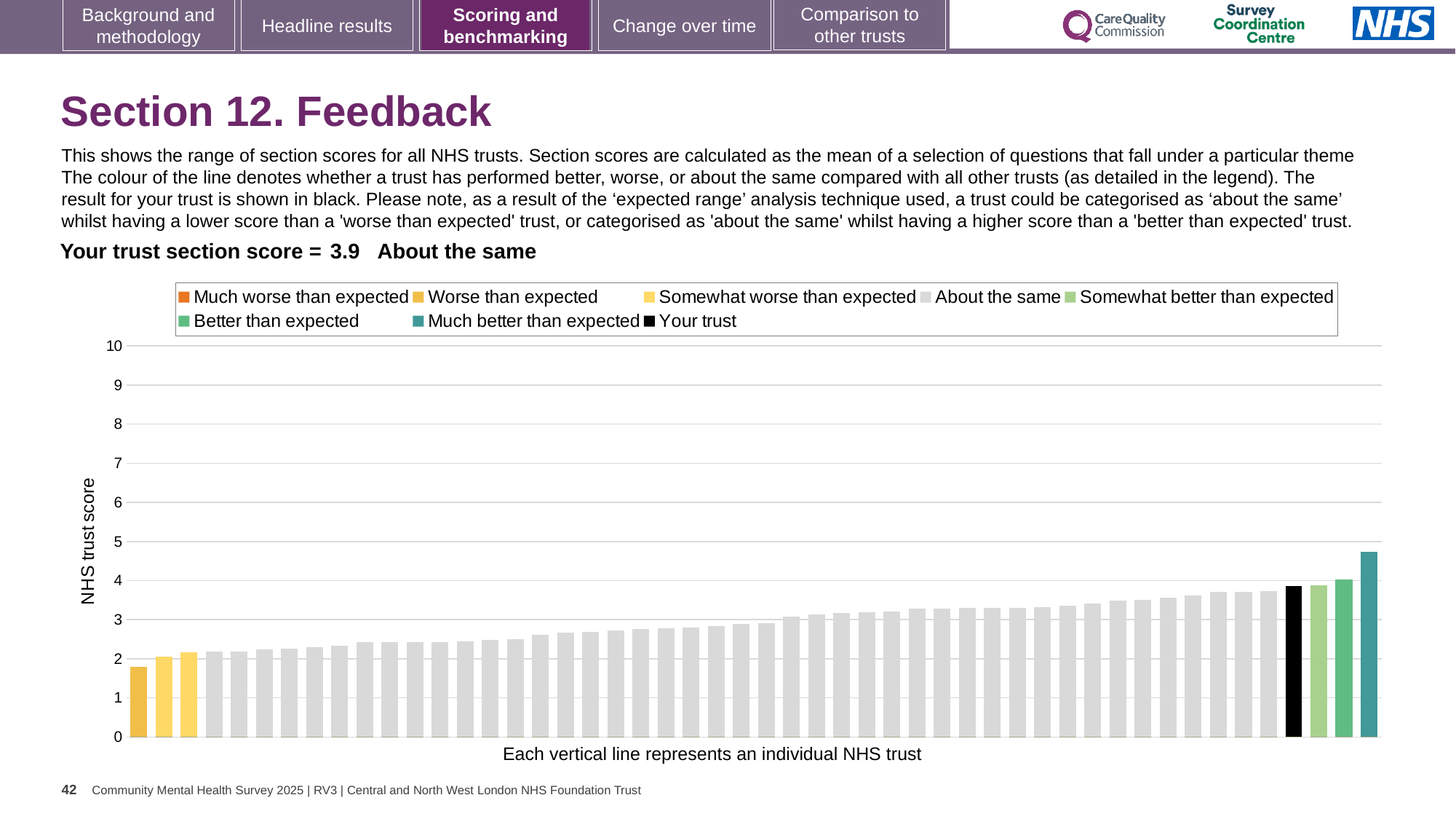
How many entries does the chart legend list? 8 What colour is used for the 'Your trust' bar in the chart? black What is the section score for your trust shown on the slide? 3.9 Do the bar values rise or fall from left to right along the x axis? rise What kind of chart is shown on the slide? bar chart Is the value of the black 'Your trust' bar greater or less than 3? greater Is the value of the tallest bar greater or less than 4? greater What is the label on the vertical axis of the chart? NHS trust score Which category is your trust placed in for this section? About the same Is the value of the shortest bar greater or less than 2? less Which legend category does the tallest bar belong to? Much better than expected